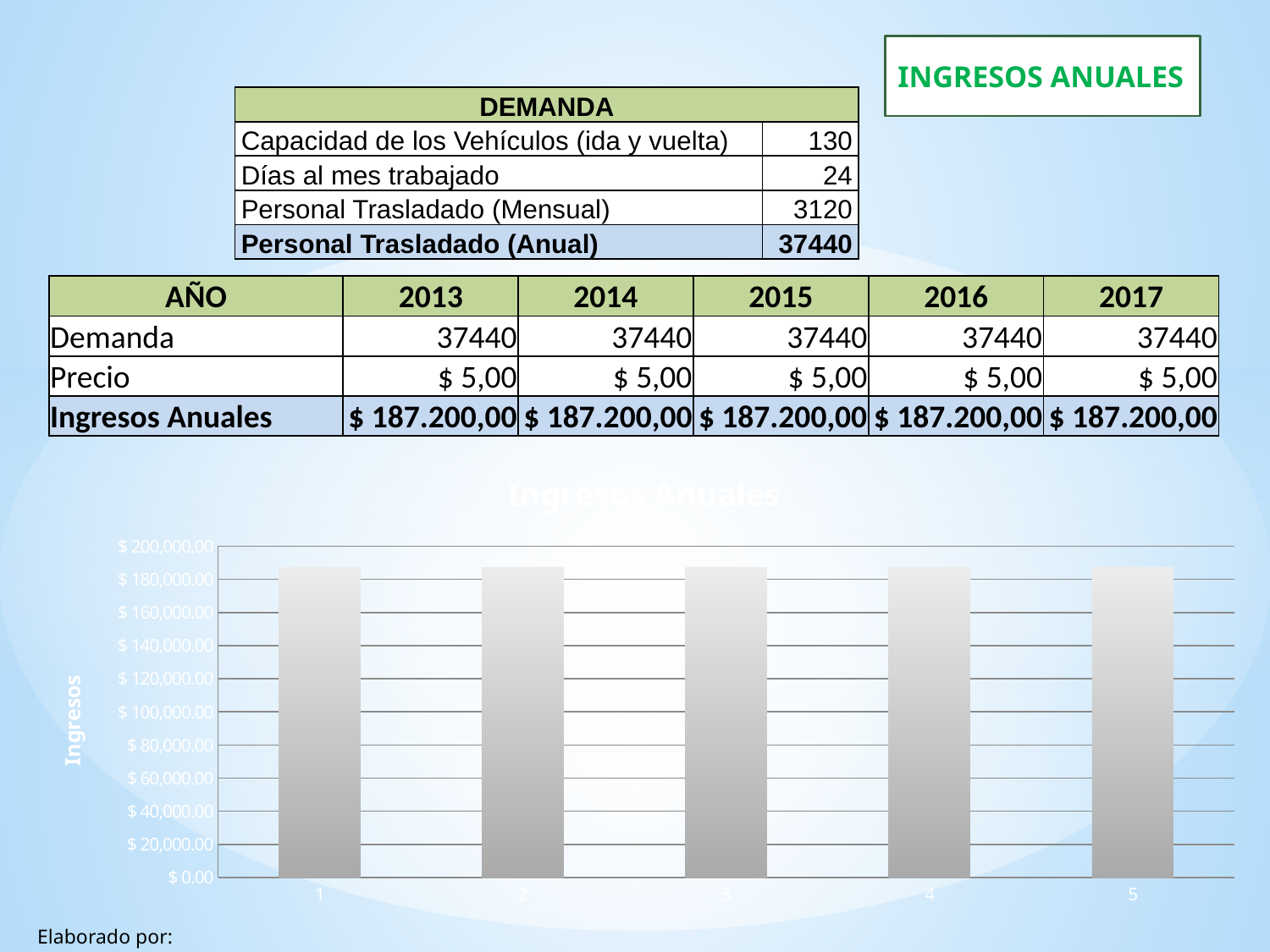
What is the title of the chart? Ingresos Anuales What kind of chart is shown on the slide? bar chart Do the bar values rise, fall, or stay the same from category 1 to category 5? stay the same Is the value for category 2 greater or less than $140,000.00? greater How many bars are plotted in the Ingresos Anuales chart? 5 What is the label on the vertical axis of the chart? Ingresos Is the value for category 3 greater or less than $200,000.00? less What is the highest tick value shown on the vertical axis? $ 200,000.00 Is the value for category 1 greater or less than $160,000.00? greater